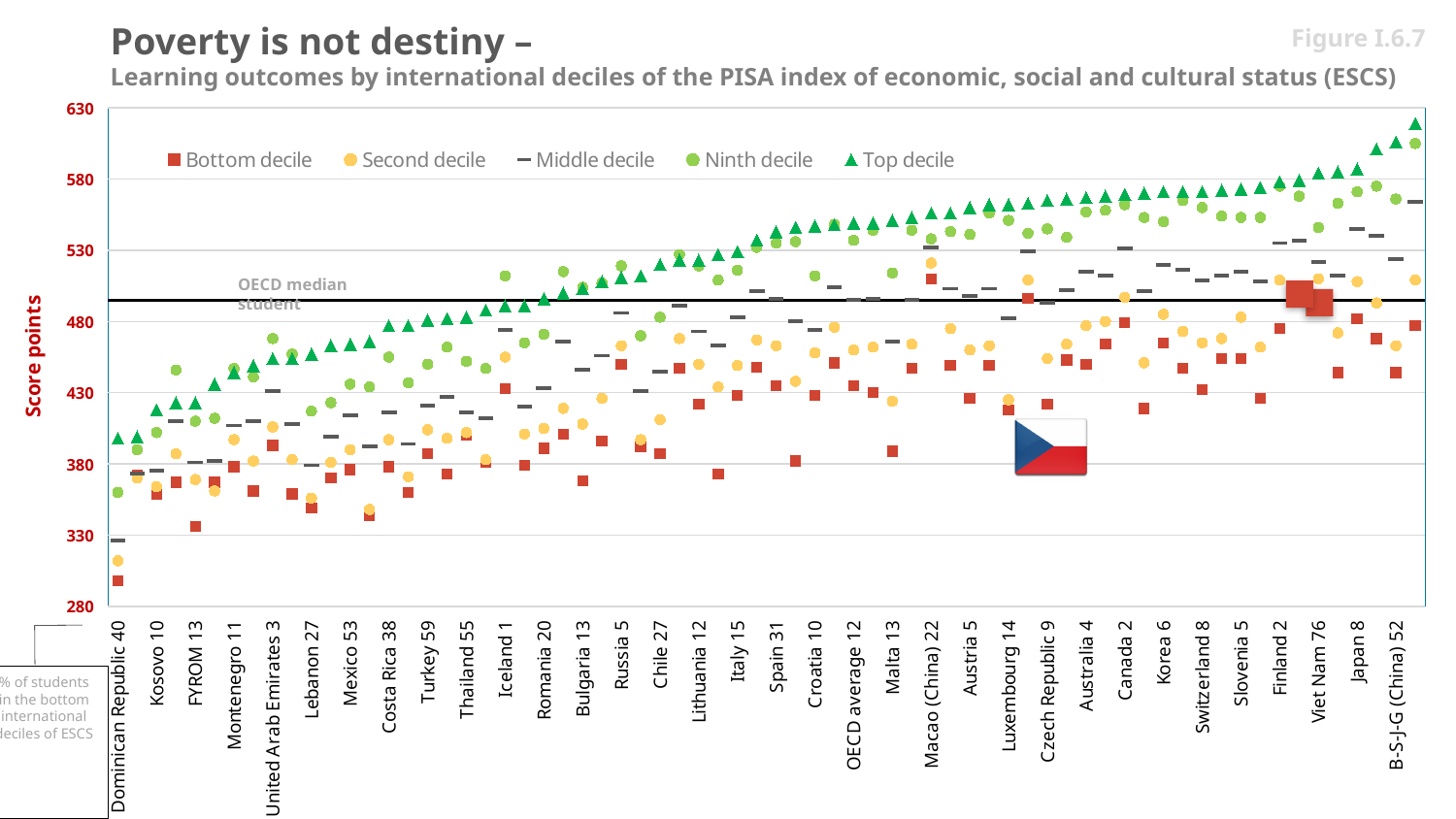
Do the Top decile values generally rise or fall from left to right along the x axis? rise Is the Bottom decile value for Dominican Republic 40 greater or less than 330? less Is the OECD median student line greater or less than 480? greater How many series does the legend list? 5 Which series is plotted with green triangles? Top decile Is the Bottom decile value for Viet Nam 76 greater or less than 480? greater What kind of chart is shown on the slide? scatter chart What is the label on the vertical axis? Score points Which is larger for Dominican Republic 40: the Top decile value or the Bottom decile value? Top decile Which has the larger Bottom decile value: Viet Nam 76 or Dominican Republic 40? Viet Nam 76